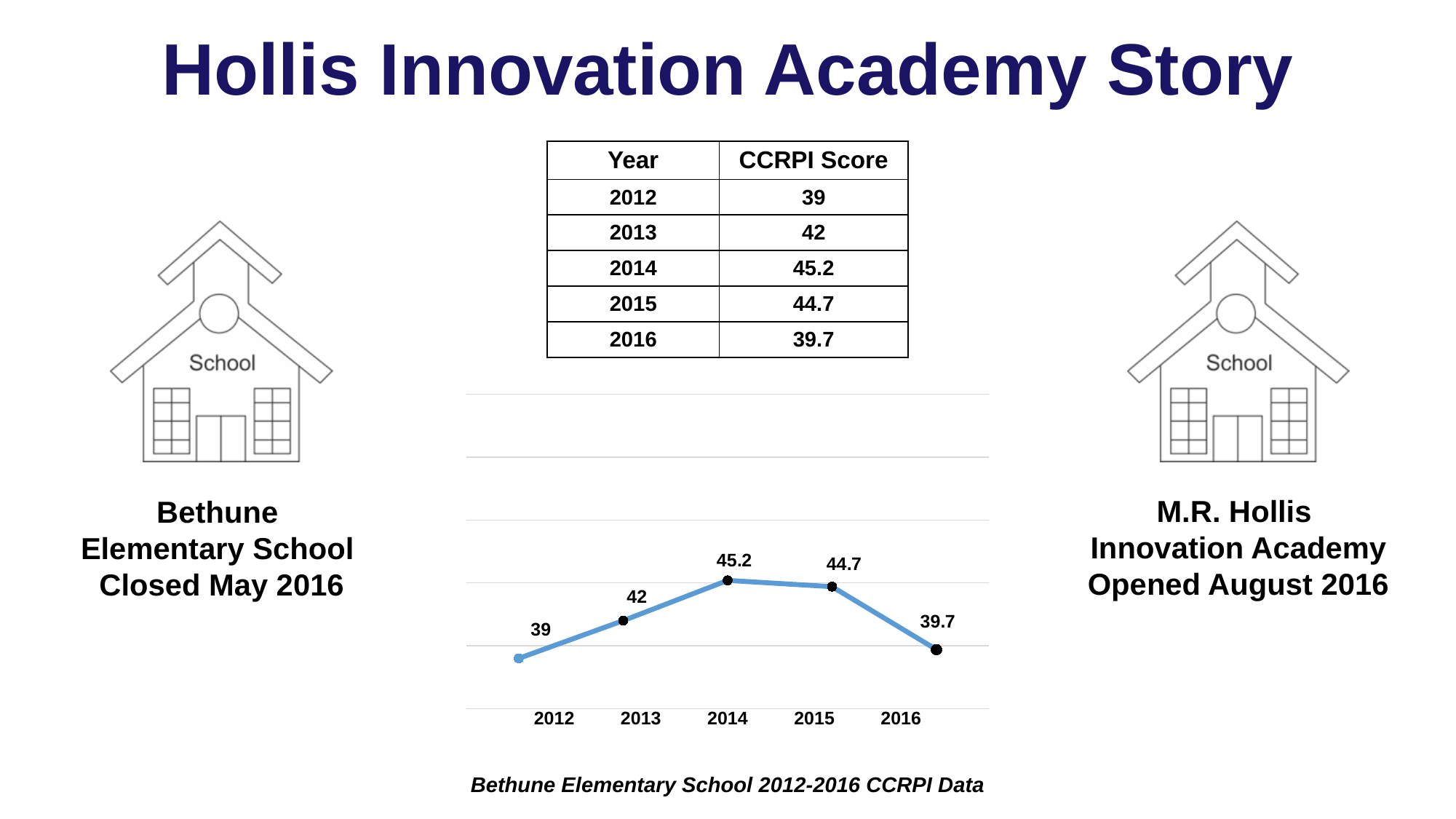
Which year has the lowest CCRPI score in the chart? 2012 What is the CCRPI score for 2014 in the line chart? 45.2 What is the difference between the CCRPI scores for 2014 and 2012? 6.2 Which year has a higher CCRPI score, 2013 or 2015? 2015 What is the caption below the line chart? Bethune Elementary School 2012-2016 CCRPI Data What kind of chart is shown on the slide? Line chart What is the difference between the CCRPI scores for 2015 and 2016? 5 Does the CCRPI score rise or fall from 2012 to 2014? Rise Which year has the highest CCRPI score in the chart? 2014 What is the CCRPI score for 2012 in the line chart? 39 How many years are plotted in the line chart? 5 What is the CCRPI score for 2016 in the line chart? 39.7